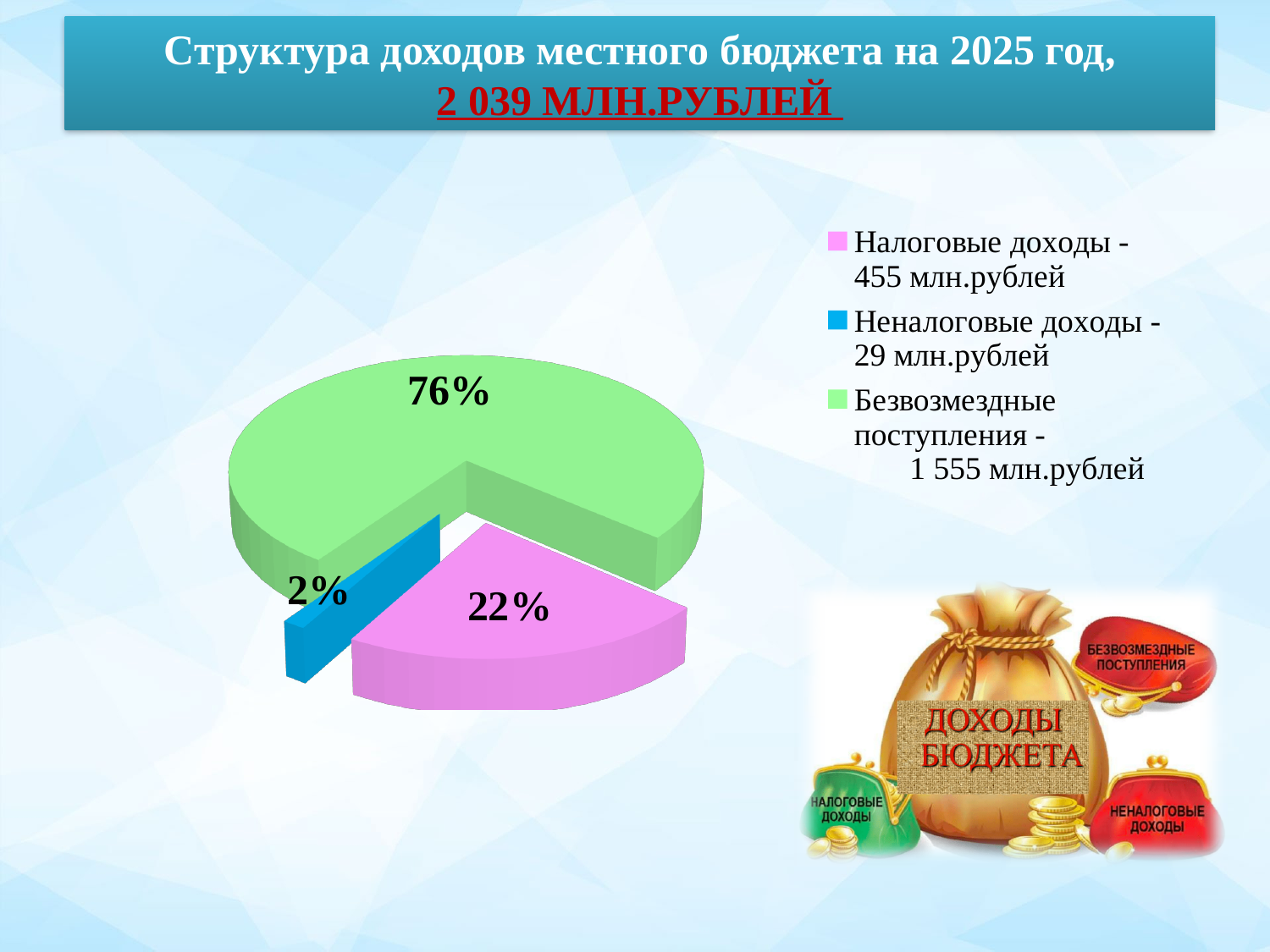
What share of the pie does Неналоговые доходы take? 2% What share of the pie does Безвозмездные поступления take? 76% How many slices does the pie chart have? 3 According to the legend, what is the amount for Налоговые доходы? 455 млн.рублей What kind of chart is shown on the slide? Pie chart Which is larger, the Налоговые доходы slice or the Неналоговые доходы slice? Налоговые доходы What is the difference in percentage points between the Безвозмездные поступления slice and the Налоговые доходы slice? 54 percentage points How many entries does the legend list? 3 What colour is the Безвозмездные поступления slice? Green Which category has the smallest slice of the pie? Неналоговые доходы Which category has the largest slice of the pie? Безвозмездные поступления What share of the pie does Налоговые доходы take? 22%